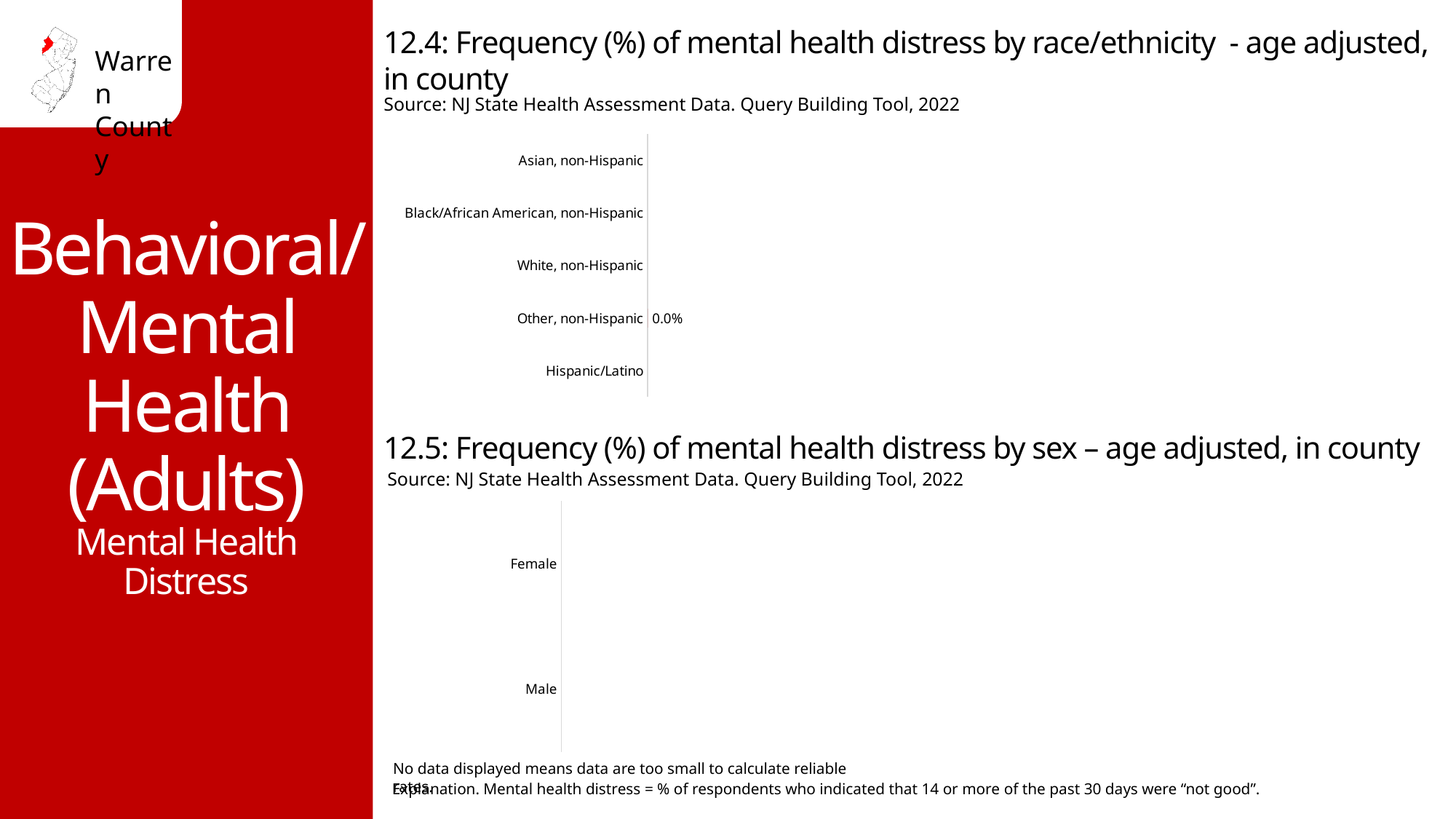
In chart 12.4, which category is listed at the top of the axis? Asian, non-Hispanic How many race/ethnicity categories are listed on the axis of chart 12.4? 5 In chart 12.4, which category is listed at the bottom of the axis? Hispanic/Latino In chart 12.4, which category is the only one with a data label displayed? Other, non-Hispanic In the chart 12.4 (mental health distress by race/ethnicity), what value is shown for Other, non-Hispanic? 0.0% What are the two categories shown on the axis of chart 12.5? Female and Male